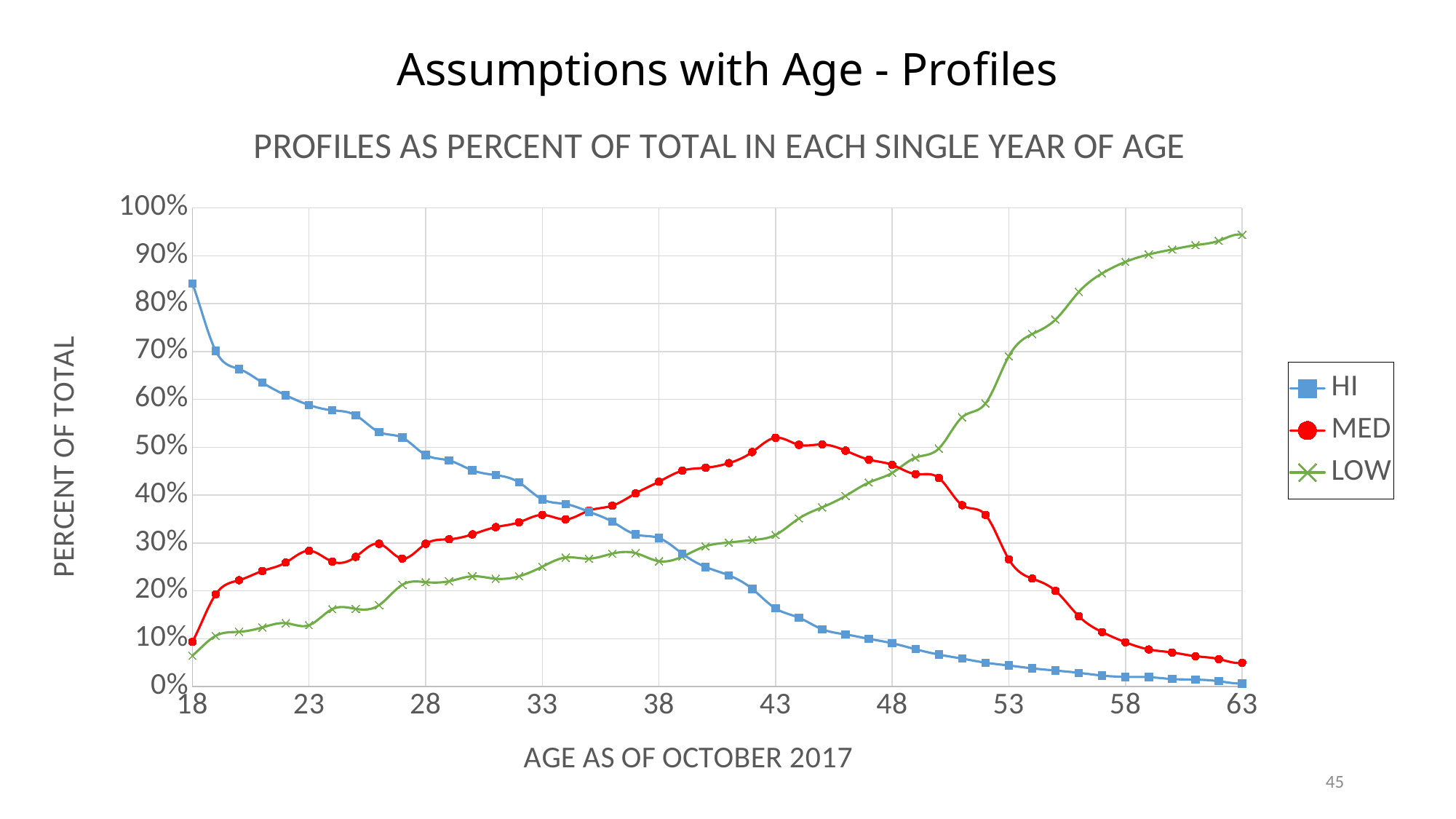
Which series has the highest value at age 18? HI How many series does the legend list? 3 Is the value for MED at age 43 greater or less than 50%? greater Is the value for HI at age 63 greater or less than 10%? less What kind of chart is shown on the slide? line chart At age 43, which is larger, MED or HI? MED What is the label of the x axis? AGE AS OF OCTOBER 2017 Is the value for LOW at age 63 greater or less than 90%? greater Does the LOW series rise or fall as age increases from 18 to 63? rise Which series has the lowest value at age 63? HI Does the HI series rise or fall as age increases from 18 to 63? fall